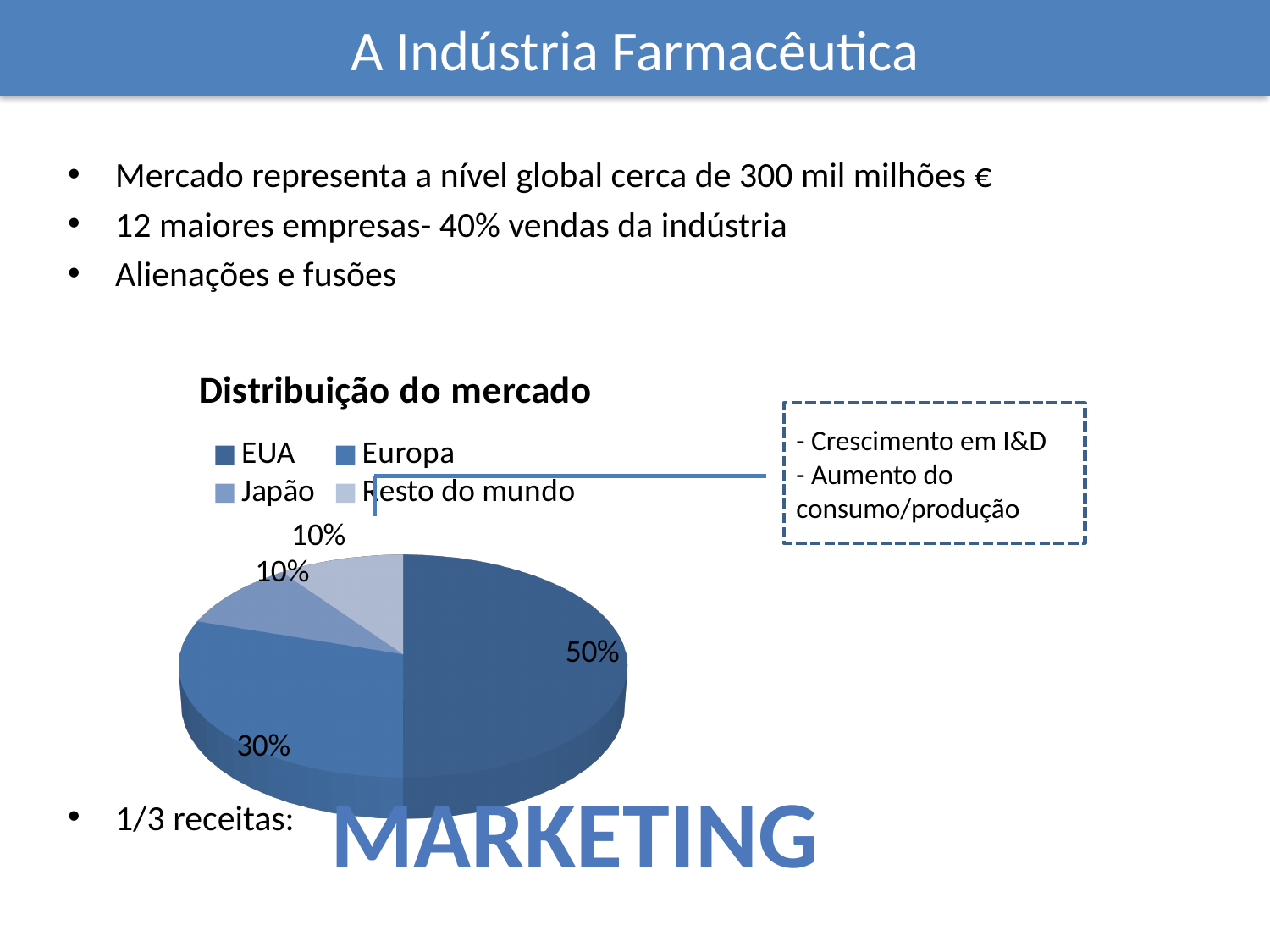
What is the difference in percentage points between the Europa slice and the Japão slice? 20% What kind of chart is shown under the title "Distribuição do mercado"? pie chart What share of the market does Europa hold in the pie chart? 30% What share of the market does Resto do mundo hold in the pie chart? 10% Which region has the largest slice in the pie chart? EUA What share of the market does Japão hold in the pie chart? 10% What is the title of the chart on the slide? Distribuição do mercado What share of the market does EUA hold in the pie chart? 50% How many slices does the pie chart have? 4 How many entries does the legend of the pie chart list? 4 What is the difference in percentage points between the EUA slice and the Europa slice? 20% Which slice is larger in the pie chart, EUA or Europa? EUA